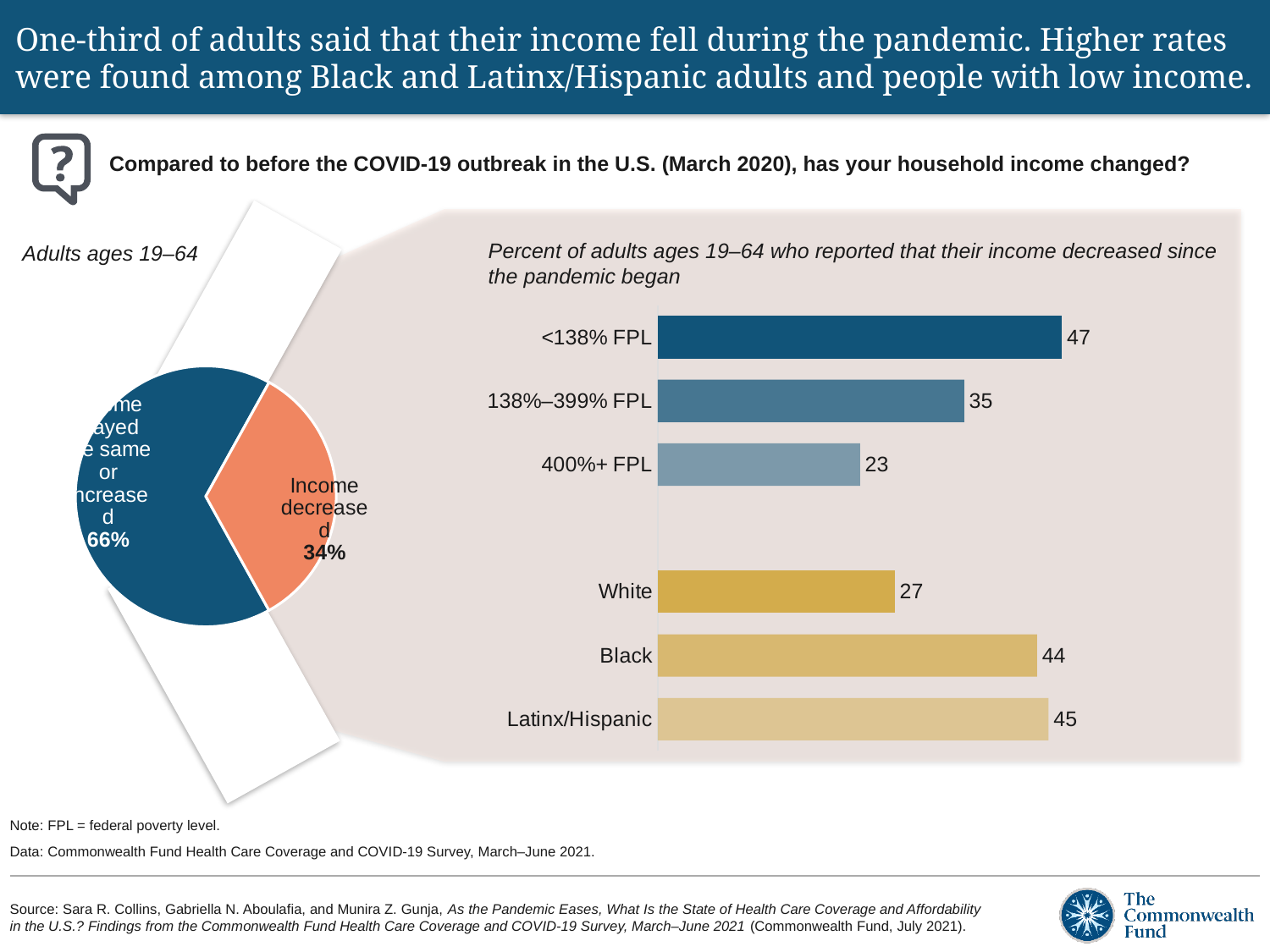
In the bar chart on the right, what is the difference between the values for Latinx/Hispanic and White adults? 18 In the bar chart on the right, which category has the lowest value? 400%+ FPL What kind of chart is on the left side of the slide? Pie chart In the pie chart on the left, what share of adults reported that their income stayed the same or increased? 66% In the bar chart on the right, what is the value for Black adults? 44 In the bar chart on the right, which is larger: the value for 138%–399% FPL or the value for White? 138%–399% FPL In the pie chart on the left, what share of adults ages 19–64 reported that their income decreased? 34% What kind of chart is on the right side of the slide? Bar chart In the bar chart on the right, what percent of adults with income <138% FPL reported that their income decreased? 47 In the bar chart on the right, which category has the highest value? <138% FPL How many categories are shown in the bar chart on the right? 6 In the bar chart on the right, what is the value for 400%+ FPL? 23